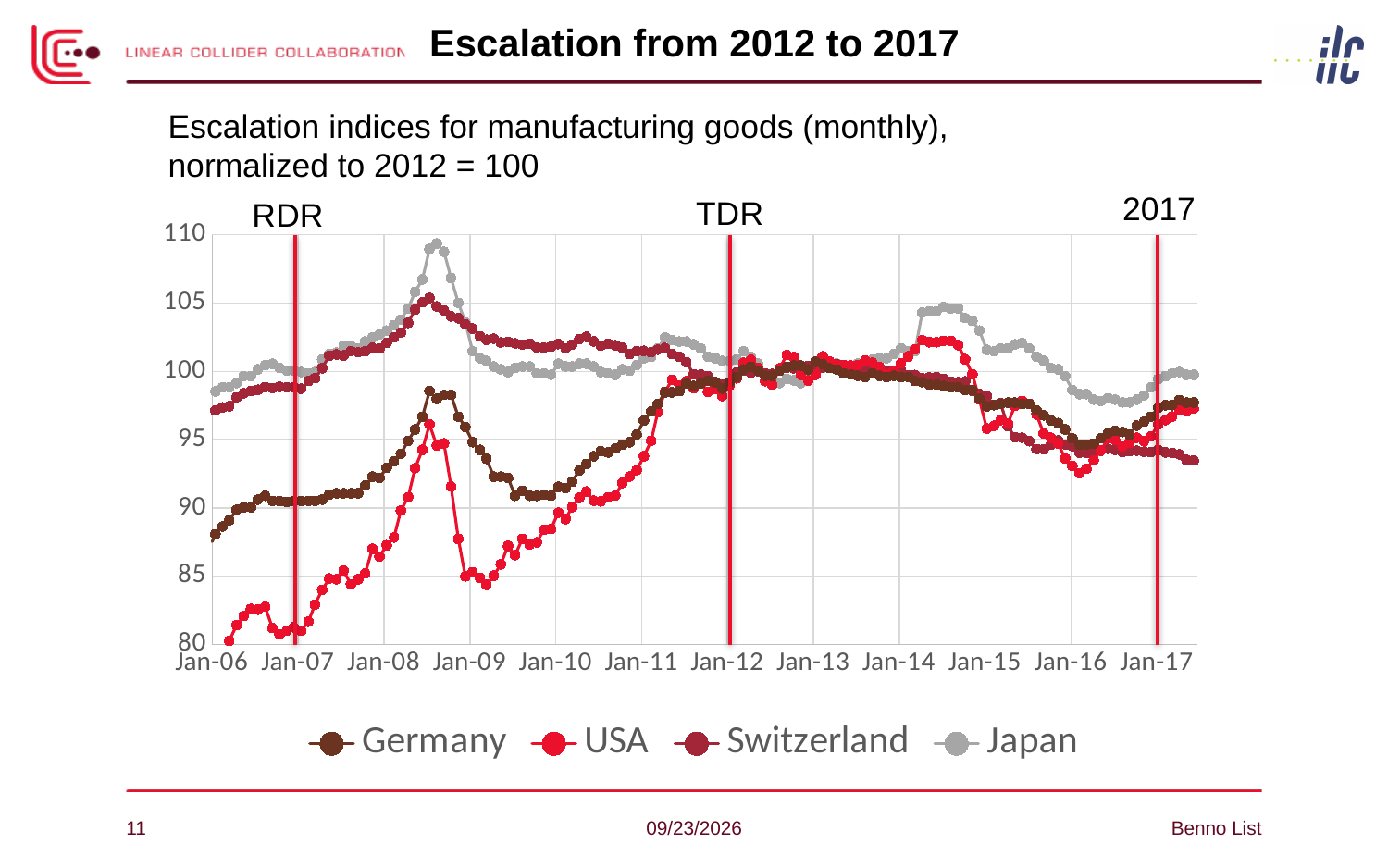
How many series does the legend list? 4 Is the peak value for Japan in 2008 greater or less than 105? greater At Jan-06, which series has the higher value, Japan or USA? Japan Is the value for USA at Jan-16 greater or less than 95? less Does the USA series rise or fall between Jan-06 and Jan-08? rise Is the value for USA at Jan-06 greater or less than 85? less Does the Japan series rise or fall between Jan-14 and Jan-16? fall What kind of chart is shown on the slide? line chart Which series reaches the highest value on the chart (around mid-2008)? Japan What label marks the vertical line at Jan-12? TDR Which series has the lowest value at Jan-06? USA